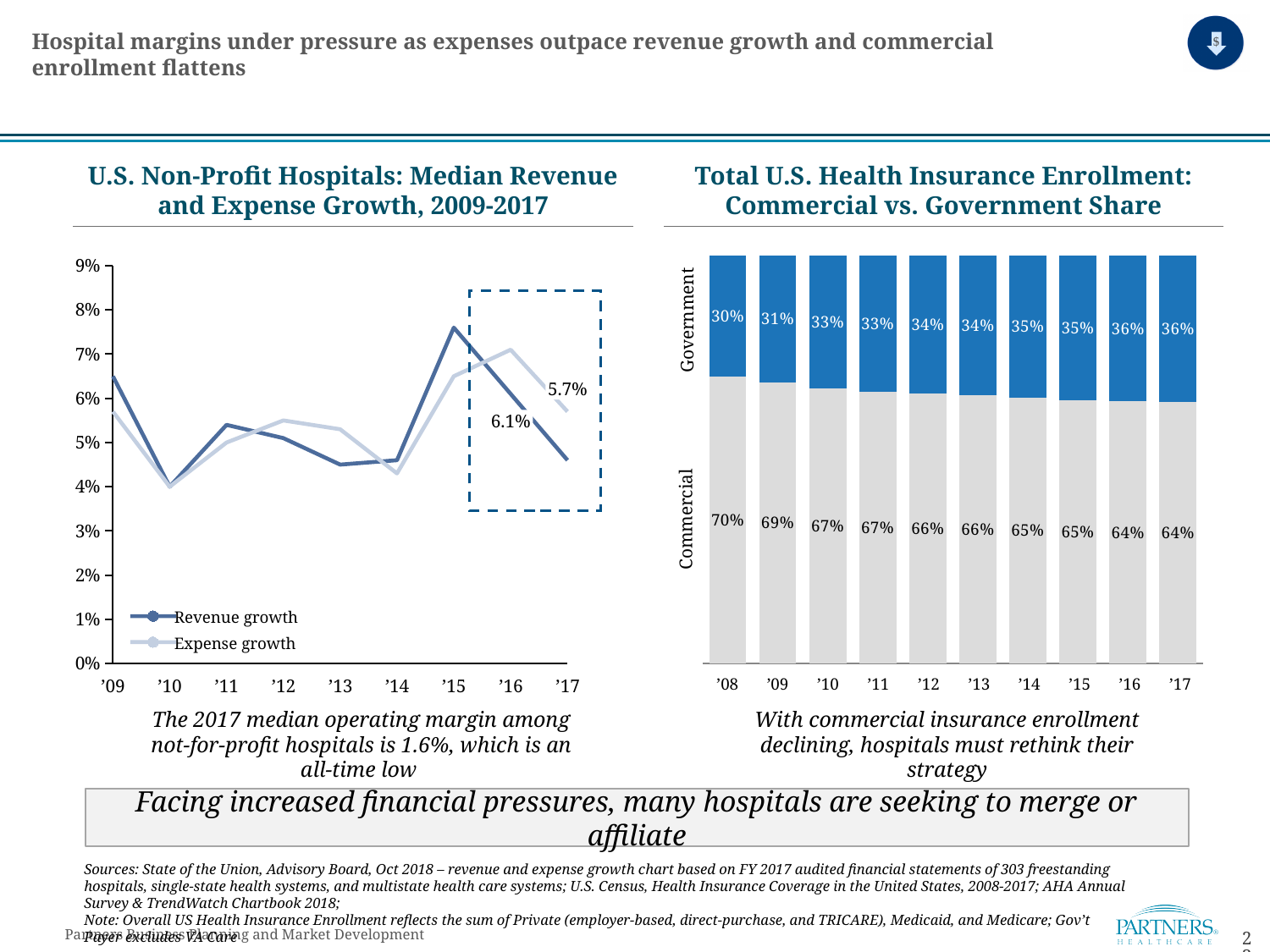
In the 'Total U.S. Health Insurance Enrollment' chart, by how many percentage points does the Commercial share in '08 exceed the Commercial share in '17? 6 percentage points In the 'Total U.S. Health Insurance Enrollment' chart, what is the Commercial share in '08? 70% How many series does the legend of the 'U.S. Non-Profit Hospitals: Median Revenue and Expense Growth' chart list? 2 In the 'Total U.S. Health Insurance Enrollment' chart, what is the Government share in '17? 36% What kind of chart is 'U.S. Non-Profit Hospitals: Median Revenue and Expense Growth, 2009-2017'? line chart In the 'Total U.S. Health Insurance Enrollment' chart, which year has the lowest Government share? '08 In the 'U.S. Non-Profit Hospitals: Median Revenue and Expense Growth' chart, is the Revenue growth value for '15 greater or less than 7%? greater In the 'Total U.S. Health Insurance Enrollment' chart, does the Commercial share rise or fall from '08 to '17? fall In the 'Total U.S. Health Insurance Enrollment' chart, how many years are shown on the x axis? 10 In the 'Total U.S. Health Insurance Enrollment' chart, what is the total of the Commercial and Government segments for '12? 100% In the 'Total U.S. Health Insurance Enrollment' chart, what is the Government share in '12? 34% In the 'U.S. Non-Profit Hospitals: Median Revenue and Expense Growth' chart, which series has the larger value in '17, Revenue growth or Expense growth? Expense growth